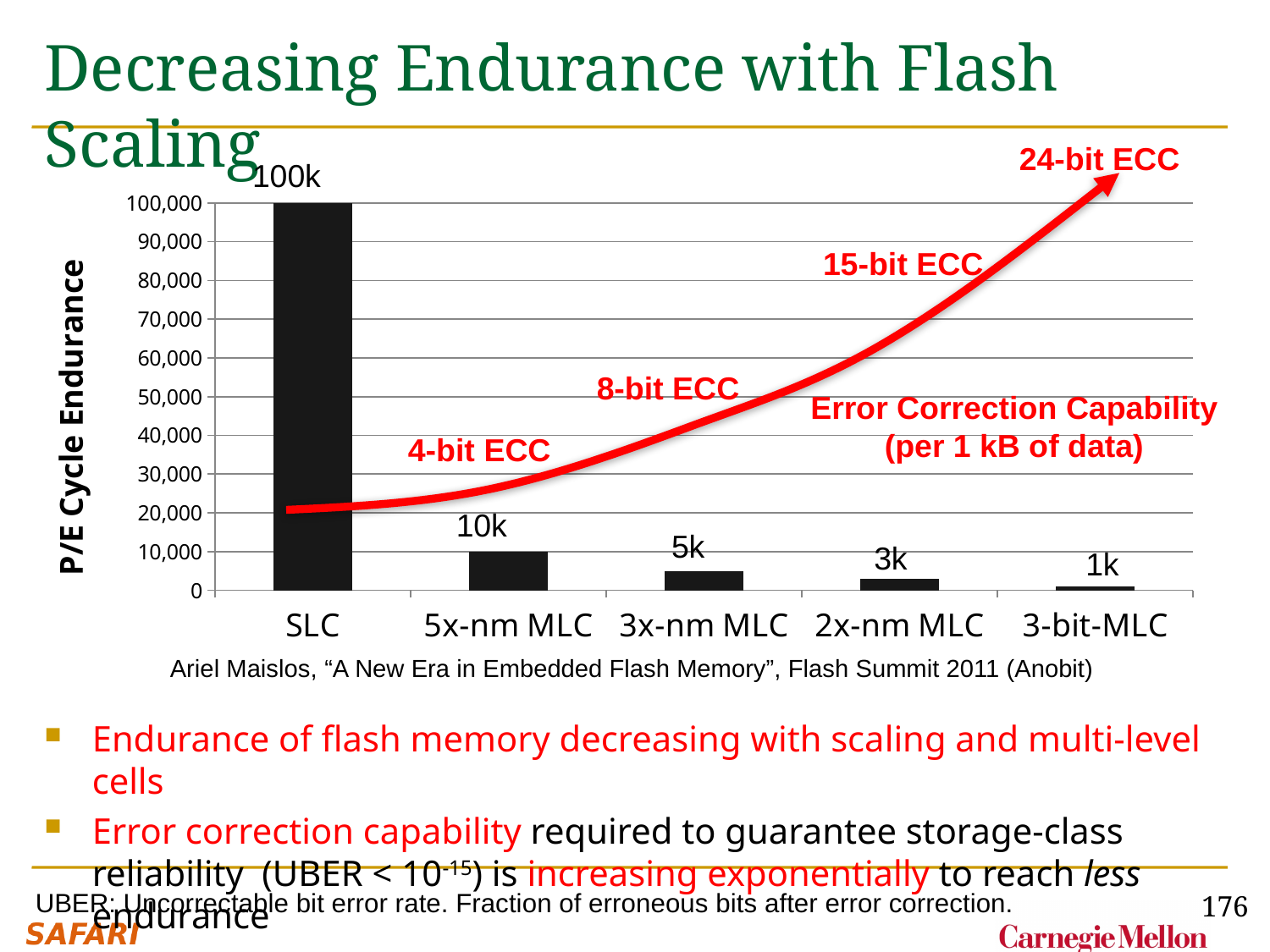
Do the bar values rise or fall from left to right along the x axis? fall Which has a higher P/E cycle endurance, 2x-nm MLC or 3-bit-MLC? 2x-nm MLC What is the difference in P/E cycle endurance between SLC and 5x-nm MLC? 90k Which category has the highest P/E cycle endurance? SLC What is the P/E cycle endurance shown for 3x-nm MLC? 5k What is the P/E cycle endurance shown for SLC? 100k Which category has the lowest P/E cycle endurance? 3-bit-MLC What is the P/E cycle endurance shown for 3-bit-MLC? 1k What kind of chart is used to show P/E cycle endurance? bar chart What is the difference in P/E cycle endurance between 5x-nm MLC and 3x-nm MLC? 5k How many categories are shown on the x axis of the chart? 5 Is the value for 5x-nm MLC greater or less than 20,000? less